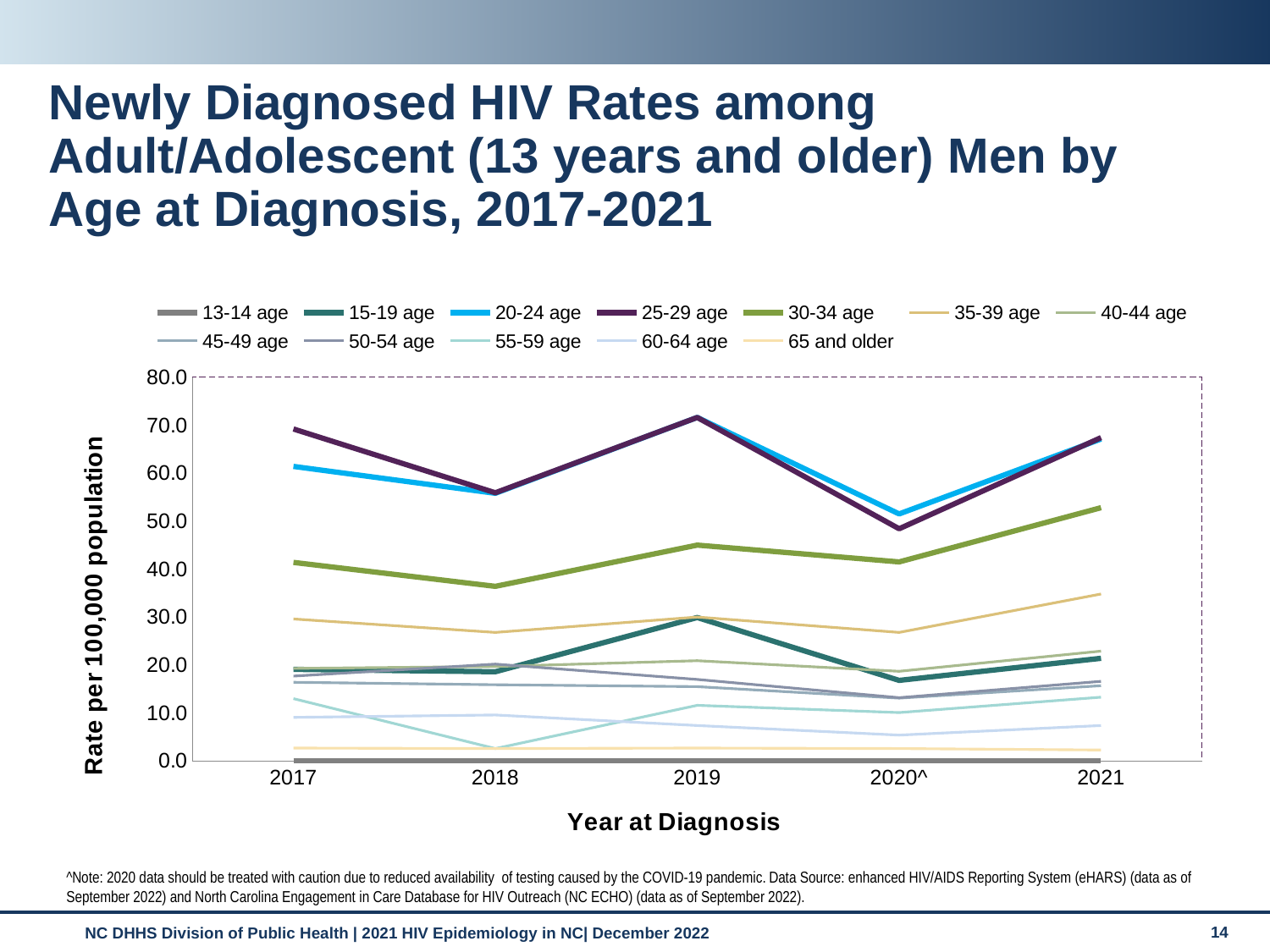
How many age-group series does the legend list? 12 Which age group has the lowest rate across all years shown? 13-14 age Is the value for the 15-19 age group in 2019 greater or less than 20? greater Does the rate for the 25-29 age group rise or fall from 2019 to 2020^? fall Which age group has the highest rate in 2017? 25-29 age What is the title of the y axis? Rate per 100,000 population How many years are plotted along the x axis? 5 What kind of chart is shown on the slide? line chart Is the value for the 55-59 age group in 2018 greater or less than 10? less Does the rate for the 30-34 age group rise or fall from 2020^ to 2021? rise Is the value for the 25-29 age group in 2017 greater or less than 60? greater In 2021, which is larger: the rate for the 30-34 age group or the 35-39 age group? 30-34 age